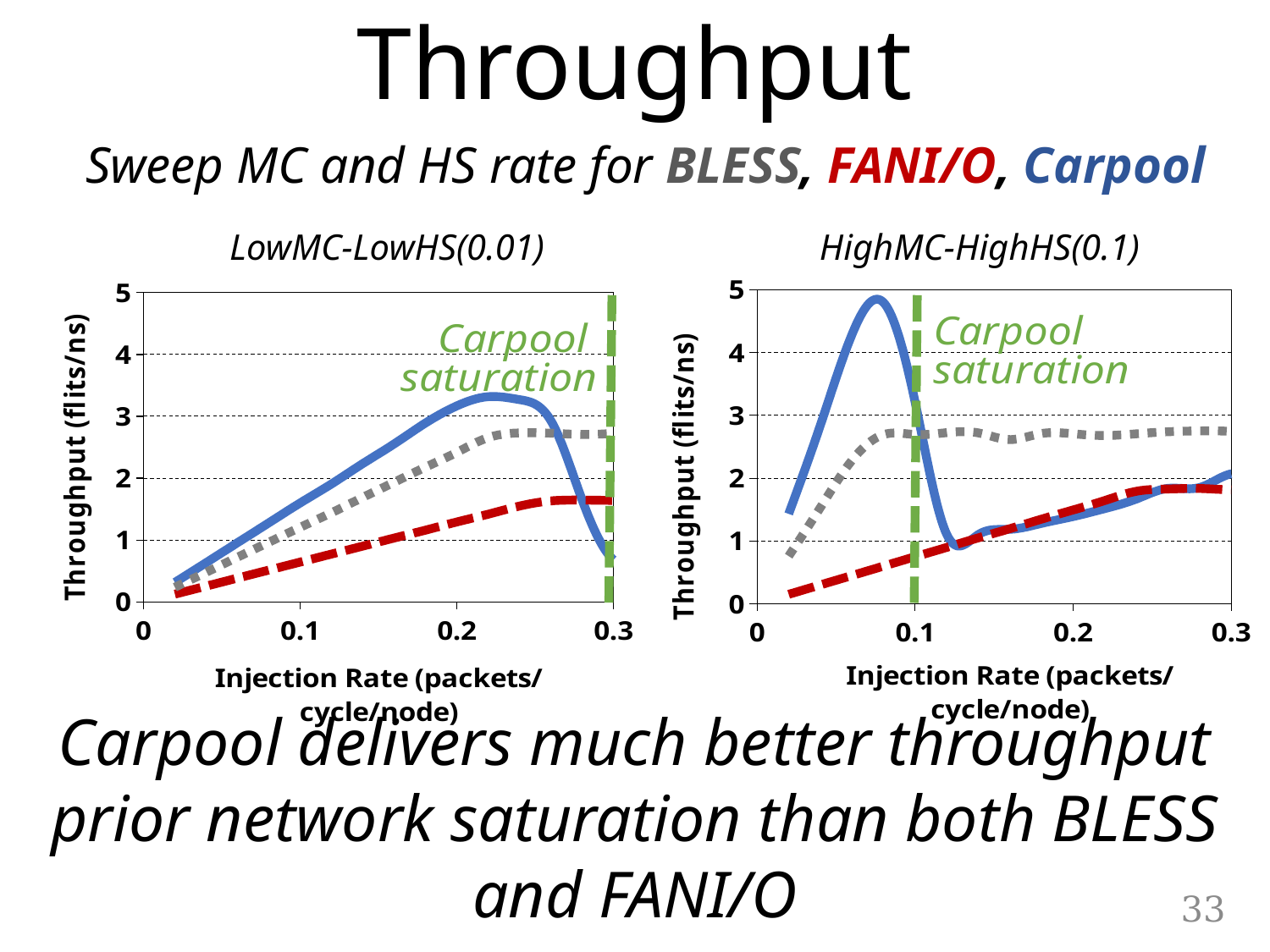
How many series are plotted in the HighMC-HighHS(0.1) chart? 3 In the HighMC-HighHS(0.1) chart, is the FANI/O value at injection rate 0.1 greater or less than 1? less In the LowMC-LowHS(0.01) chart, is the peak value of the Carpool line greater or less than 3? greater What is the x-axis label of the HighMC-HighHS(0.1) chart? Injection Rate (packets/cycle/node) In the LowMC-LowHS(0.01) chart, is the FANI/O value at injection rate 0.3 greater or less than 2? less What kind of chart is the LowMC-LowHS(0.01) chart? line chart In the LowMC-LowHS(0.01) chart, at injection rate 0.2, which is larger: Carpool or FANI/O? Carpool In the HighMC-HighHS(0.1) chart, at injection rate 0.3, which is larger: BLESS or Carpool? BLESS In the LowMC-LowHS(0.01) chart, does the FANI/O line generally rise or fall as injection rate increases from 0 to 0.25? rise In the HighMC-HighHS(0.1) chart, which series reaches the highest throughput? Carpool